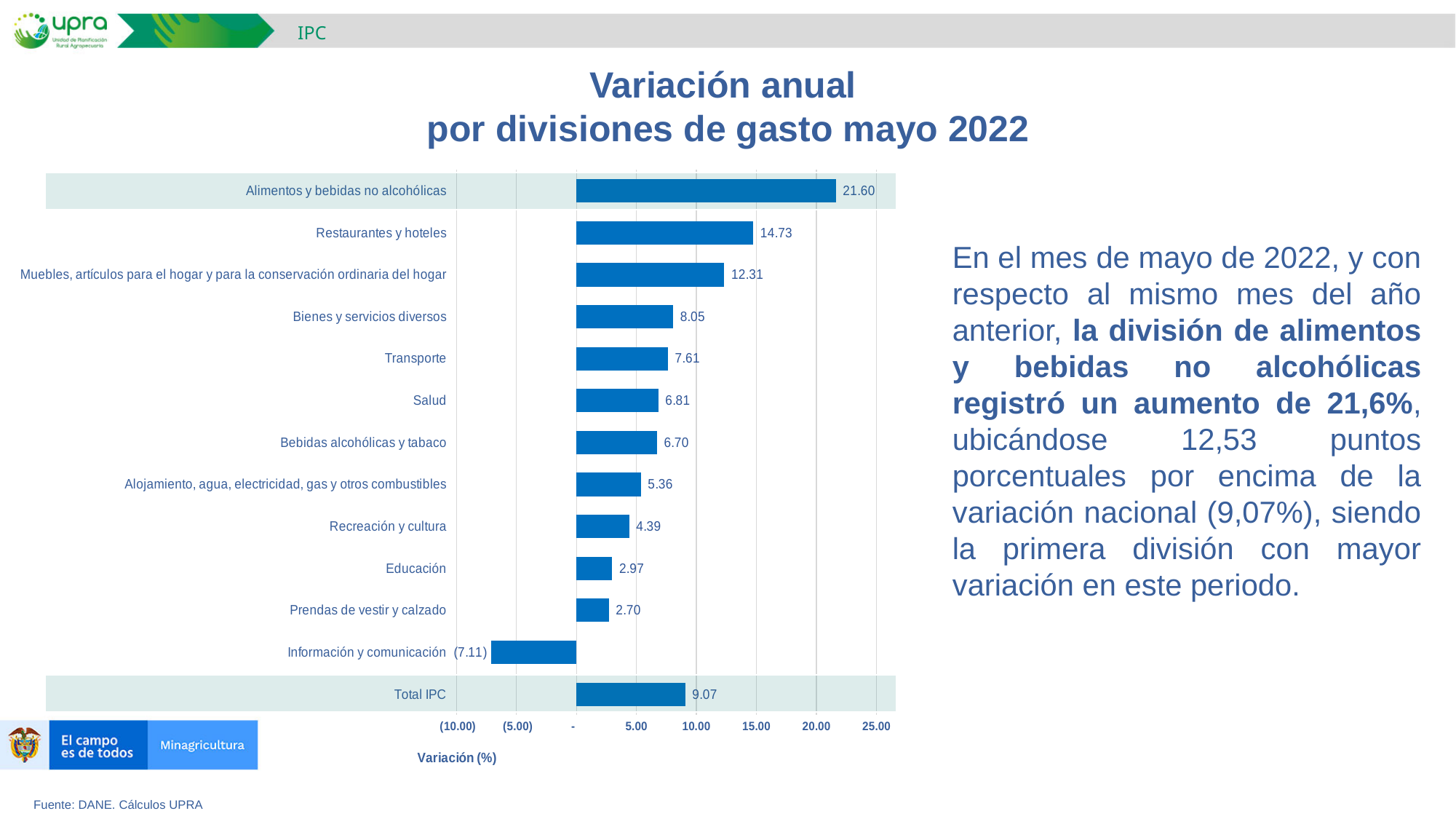
What is the value for Información y comunicación? (7.11) Which category has the lowest value? Información y comunicación What is the value for Transporte? 7.61 What is the label of the horizontal axis? Variación (%) What is the value for Alimentos y bebidas no alcohólicas? 21.60 What is the difference between Alimentos y bebidas no alcohólicas and Total IPC? 12.53 What is the difference between Restaurantes y hoteles and Muebles, artículos para el hogar y para la conservación ordinaria del hogar? 2.42 How many bars are plotted in the chart? 13 What kind of chart is shown on the slide? Bar chart What is the value for Total IPC? 9.07 Which category has the highest value? Alimentos y bebidas no alcohólicas Which is larger, the value for Salud or the value for Recreación y cultura? Salud